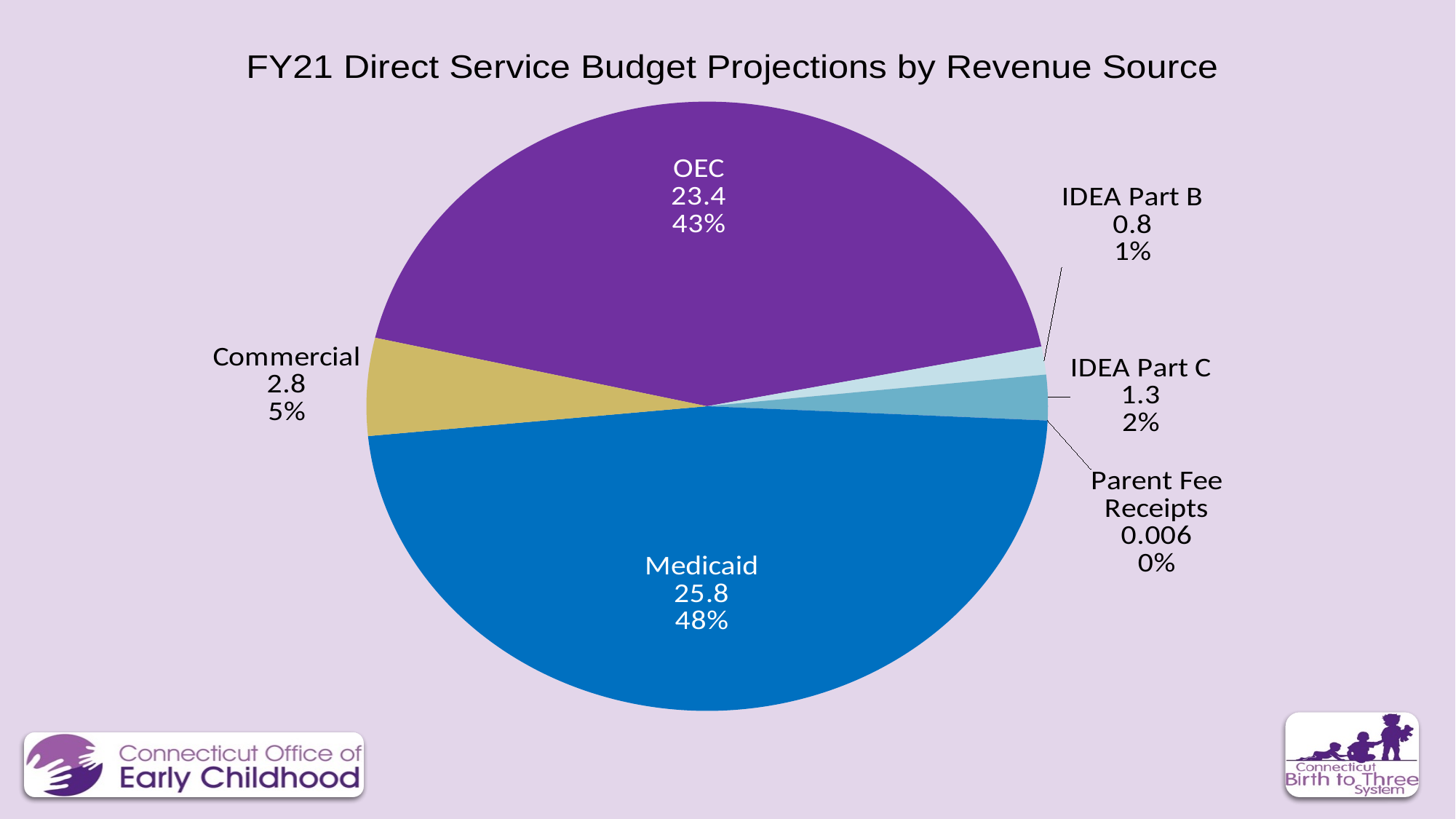
How many slices does the pie chart have? 6 What is the value shown for Commercial? 2.8 What percentage share does OEC have? 43% What type of chart is shown on the slide? pie chart Which revenue source has the largest slice? Medicaid What is the value shown for Medicaid? 25.8 What is the title of the chart? FY21 Direct Service Budget Projections by Revenue Source Which is larger, IDEA Part B or IDEA Part C? IDEA Part C What is the value shown for Parent Fee Receipts? 0.006 What percentage share does IDEA Part C have? 2% Which revenue source has the smallest slice? Parent Fee Receipts What is the difference between the Medicaid value and the OEC value? 2.4